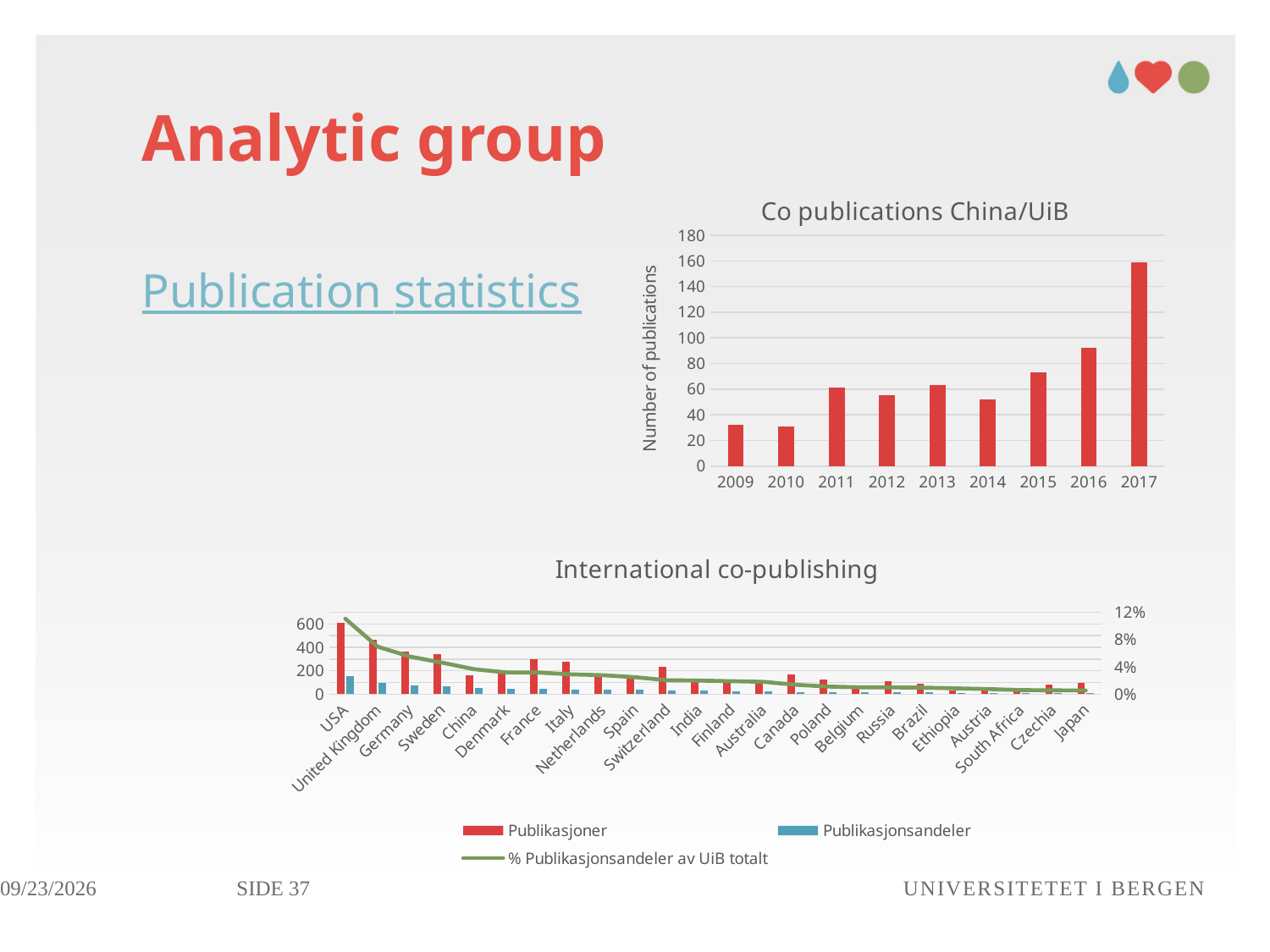
In the 'Co publications China/UiB' chart, which is larger, the value for 2015 or the value for 2014? 2015 How many years are shown on the x axis of the 'Co publications China/UiB' chart? 9 In the 'Co publications China/UiB' chart, is the value for 2016 greater or less than 80? greater In the 'International co-publishing' chart, which country has the highest number of Publikasjoner? USA How many series does the legend of the 'International co-publishing' chart list? 3 How many countries are shown on the x axis of the 'International co-publishing' chart? 24 In the 'Co publications China/UiB' chart, is the value for 2009 greater or less than 40? less In the 'Co publications China/UiB' chart, which year has the highest number of publications? 2017 In the 'Co publications China/UiB' chart, is the value for 2017 greater or less than 140? greater What kind of chart is 'Co publications China/UiB'? Bar chart What is the y-axis title of the 'Co publications China/UiB' chart? Number of publications In the 'International co-publishing' chart, does the '% Publikasjonsandeler av UiB totalt' line rise or fall from USA to Japan? Fall